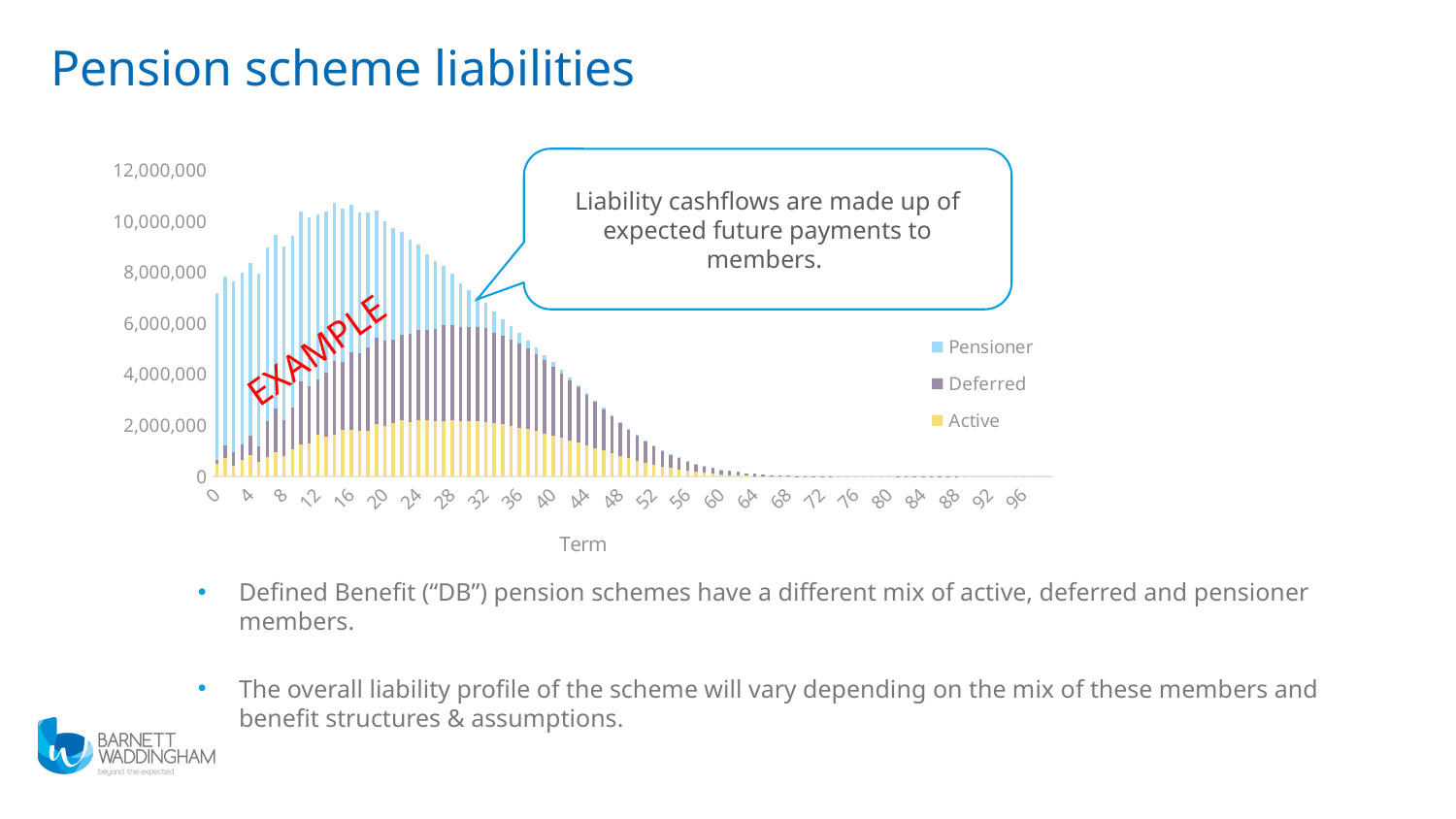
How many series does the chart's legend list? 3 What kind of chart is shown on the slide? stacked bar chart Is the total value of the bar at term 40 greater or less than 6,000,000? less Is the total value of the bar at term 16 greater or less than 10,000,000? greater Do the total bar values rise or fall along the x axis from term 0 to term 12? rise Which bar has the larger total value, term 8 or term 48? term 8 What is the title of the chart's x axis? Term Do the total bar values rise or fall along the x axis from term 40 to term 96? fall Is the total value of the bar at term 0 greater or less than 6,000,000? greater Which bar has the larger total value, term 16 or term 60? term 16 What are the three series listed in the chart's legend? Pensioner, Deferred, Active